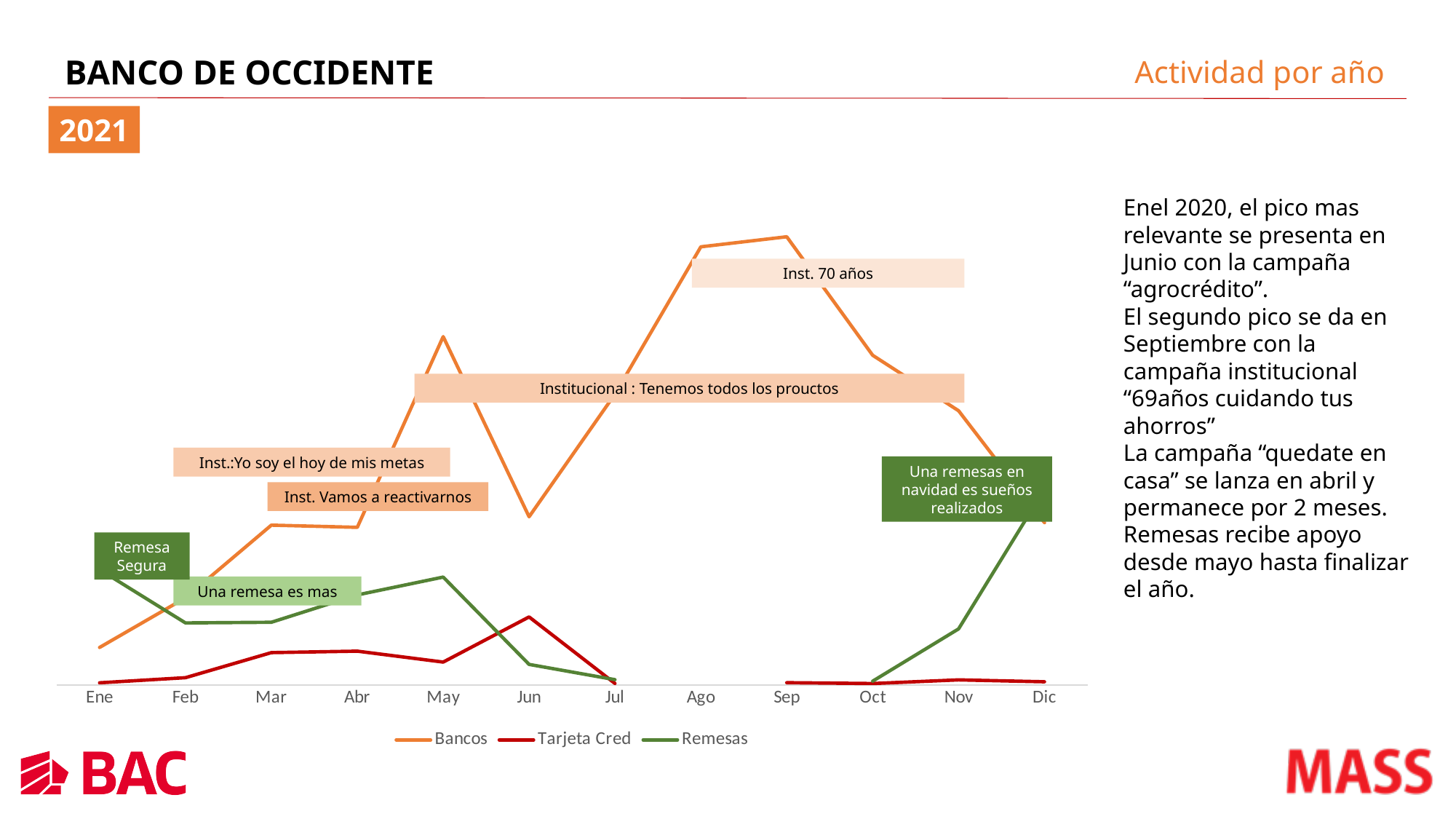
How many months are shown on the x axis of the chart? 12 Which colour is used for the Remesas series in the chart? Green What kind of chart is shown on the slide? Line chart In which month does the Tarjeta Cred series reach its highest value? Jun How many series does the chart legend list? 3 Does the Bancos series rise or fall from Sep to Dic? Fall Does the Bancos series rise or fall from Jun to Sep? Rise In which month does the Remesas series reach its highest value? Dic In which month does the Bancos series have its lowest value? Ene In Dic, which series has the larger value, Remesas or Tarjeta Cred? Remesas In which month does the Bancos series reach its highest value? Sep